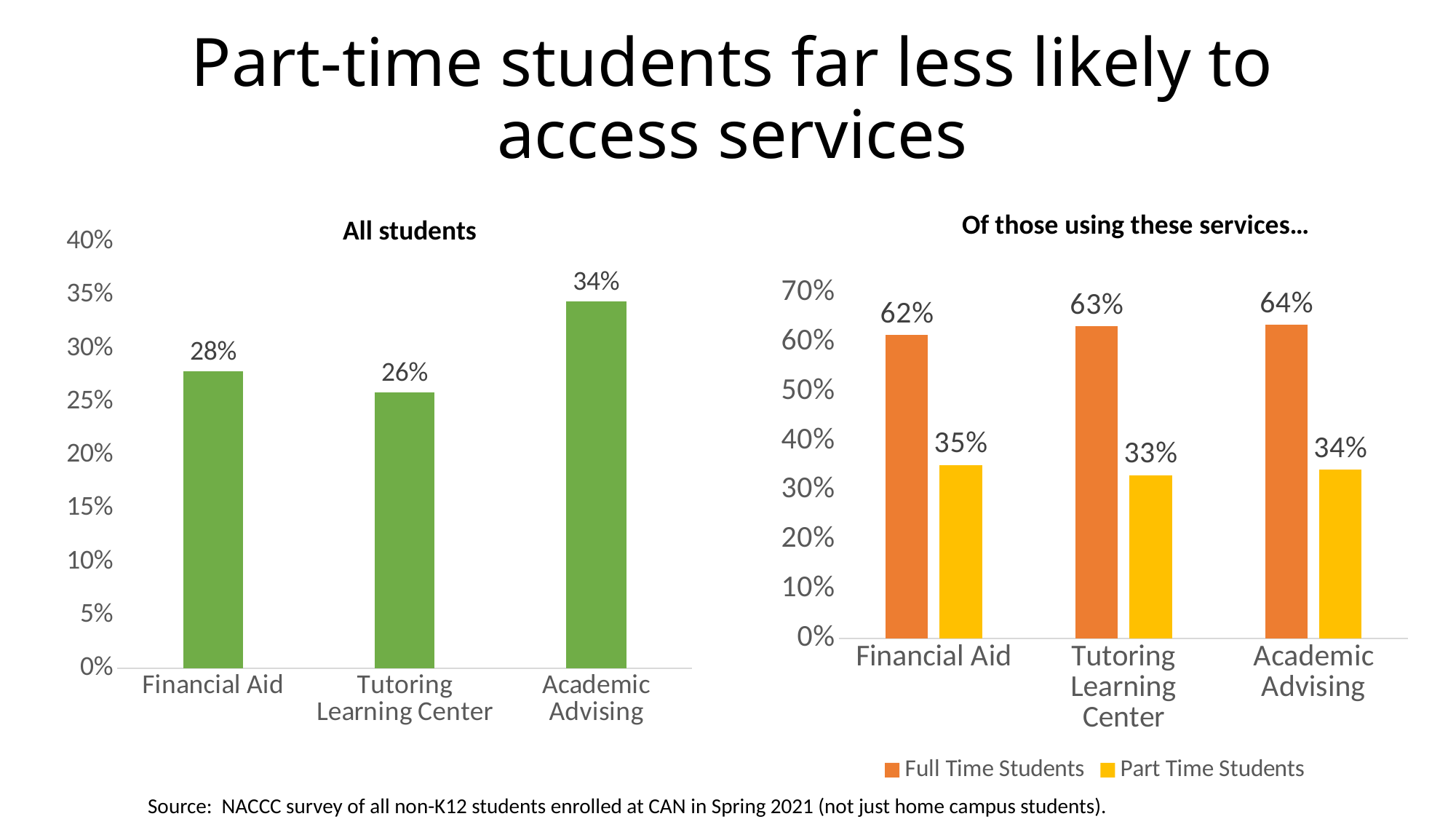
In the 'Of those using these services…' chart, which category has the highest Full Time Students value? Academic Advising In the 'All students' chart, what is the value for Academic Advising? 34% What kind of chart is the 'All students' chart? Bar chart In the 'All students' chart, what is the difference between Academic Advising and Financial Aid? 6% In the 'Of those using these services…' chart, what is the difference between Full Time Students and Part Time Students for Financial Aid? 27% In the 'All students' chart, how many categories are shown? 3 In the 'Of those using these services…' chart, which is larger for Academic Advising: Full Time Students or Part Time Students? Full Time Students In the 'Of those using these services…' chart, how many series does the legend list? 2 In the 'Of those using these services…' chart, what colour are the Part Time Students bars? Yellow In the 'All students' chart, which category has the lowest value? Tutoring Learning Center In the 'Of those using these services…' chart, what is the value for Part Time Students for Tutoring Learning Center? 33% In the 'Of those using these services…' chart, what is the value for Full Time Students for Academic Advising? 64%